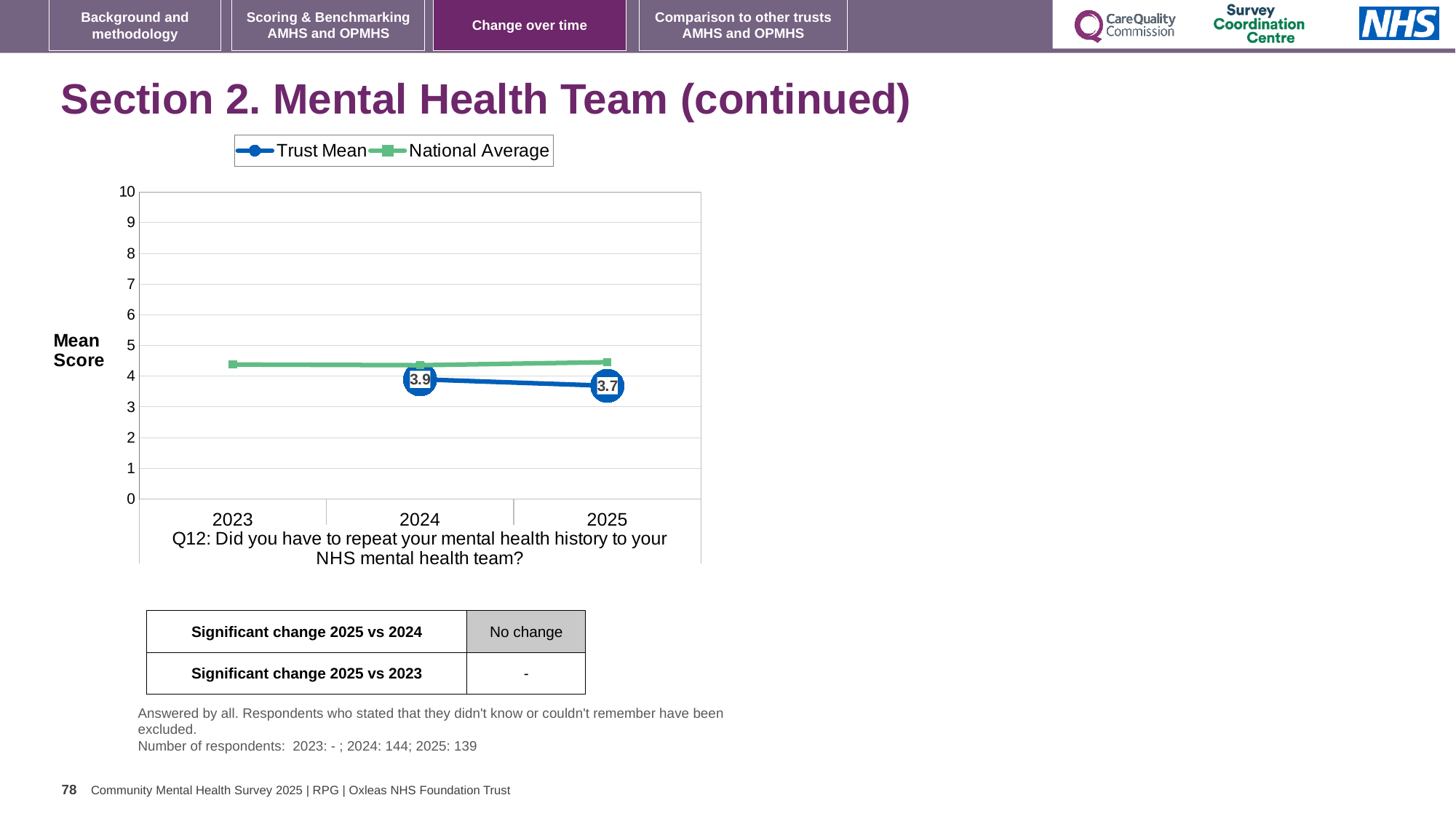
Which year has the higher Trust Mean score, 2024 or 2025? 2024 How many years are shown on the x axis of the chart? 3 What is the label on the y axis of the chart? Mean Score What is the Trust Mean score for 2025? 3.7 What type of chart is shown on the slide? line chart Is the National Average value for 2023 greater or less than 4? greater In 2025, which series is higher, Trust Mean or National Average? National Average Does the Trust Mean rise or fall from 2024 to 2025? fall How many series does the chart legend list? 2 By how much did the Trust Mean score change between 2024 and 2025? 0.2 What is the Trust Mean score for 2024? 3.9 Is the National Average value for 2025 greater or less than 5? less